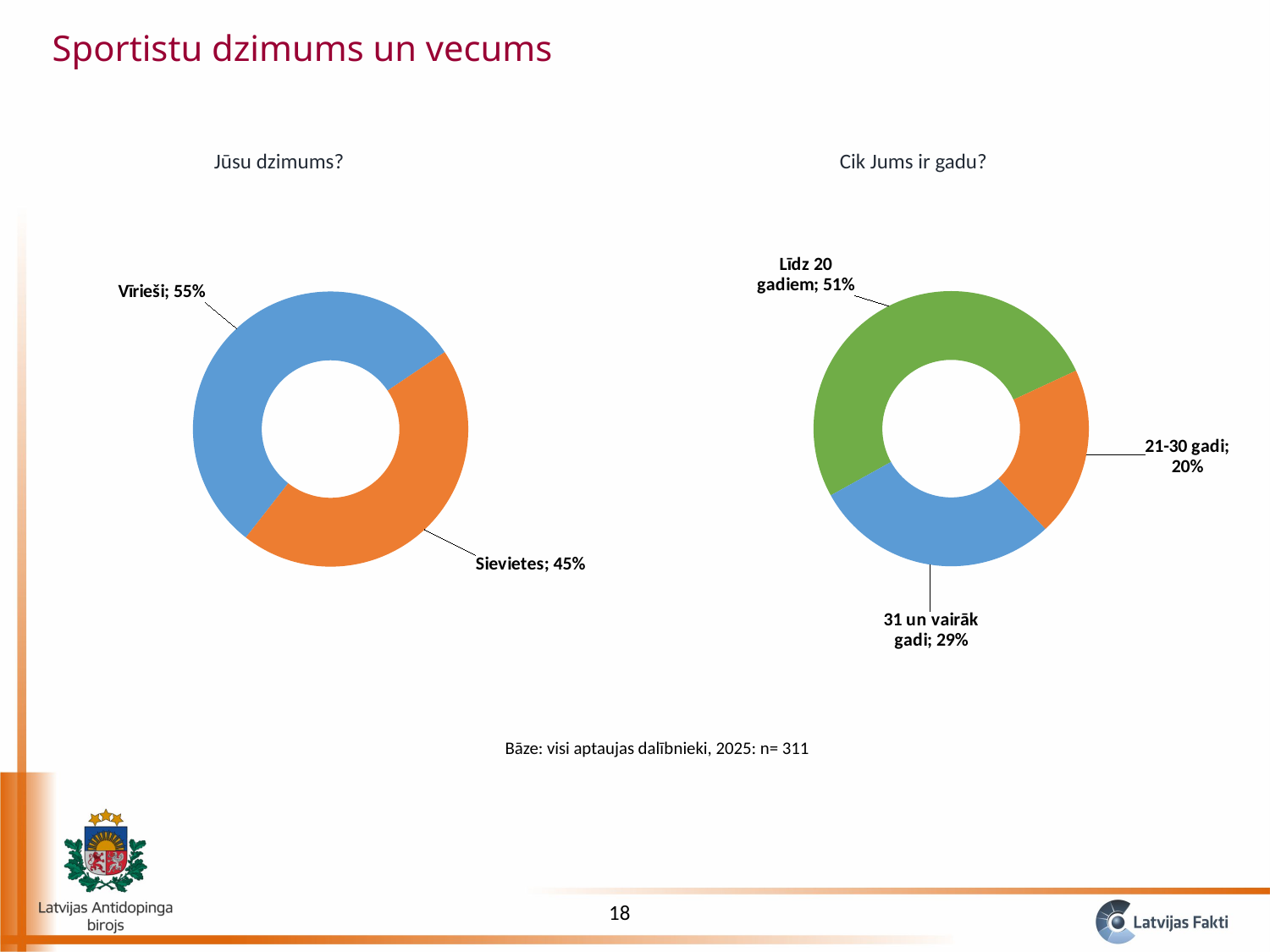
In the "Cik Jums ir gadu?" chart, which category has the smallest share? 21-30 gadi In the "Jūsu dzimums?" chart, what is the value for Vīrieši? 55% In the "Cik Jums ir gadu?" chart, which category has the largest share? Līdz 20 gadiem In the "Cik Jums ir gadu?" chart, what is the value for 31 un vairāk gadi? 29% What kind of chart is the "Jūsu dzimums?" chart? Doughnut (pie) chart In the "Jūsu dzimums?" chart, what is the value for Sievietes? 45% In the "Cik Jums ir gadu?" chart, what is the value for Līdz 20 gadiem? 51% In the "Cik Jums ir gadu?" chart, which is larger: 31 un vairāk gadi or 21-30 gadi? 31 un vairāk gadi In the "Jūsu dzimums?" chart, which category has the larger share? Vīrieši In the "Jūsu dzimums?" chart, what is the difference between Vīrieši and Sievietes? 10% How many categories does the "Cik Jums ir gadu?" chart show? 3 In the "Cik Jums ir gadu?" chart, what is the value for 21-30 gadi? 20%